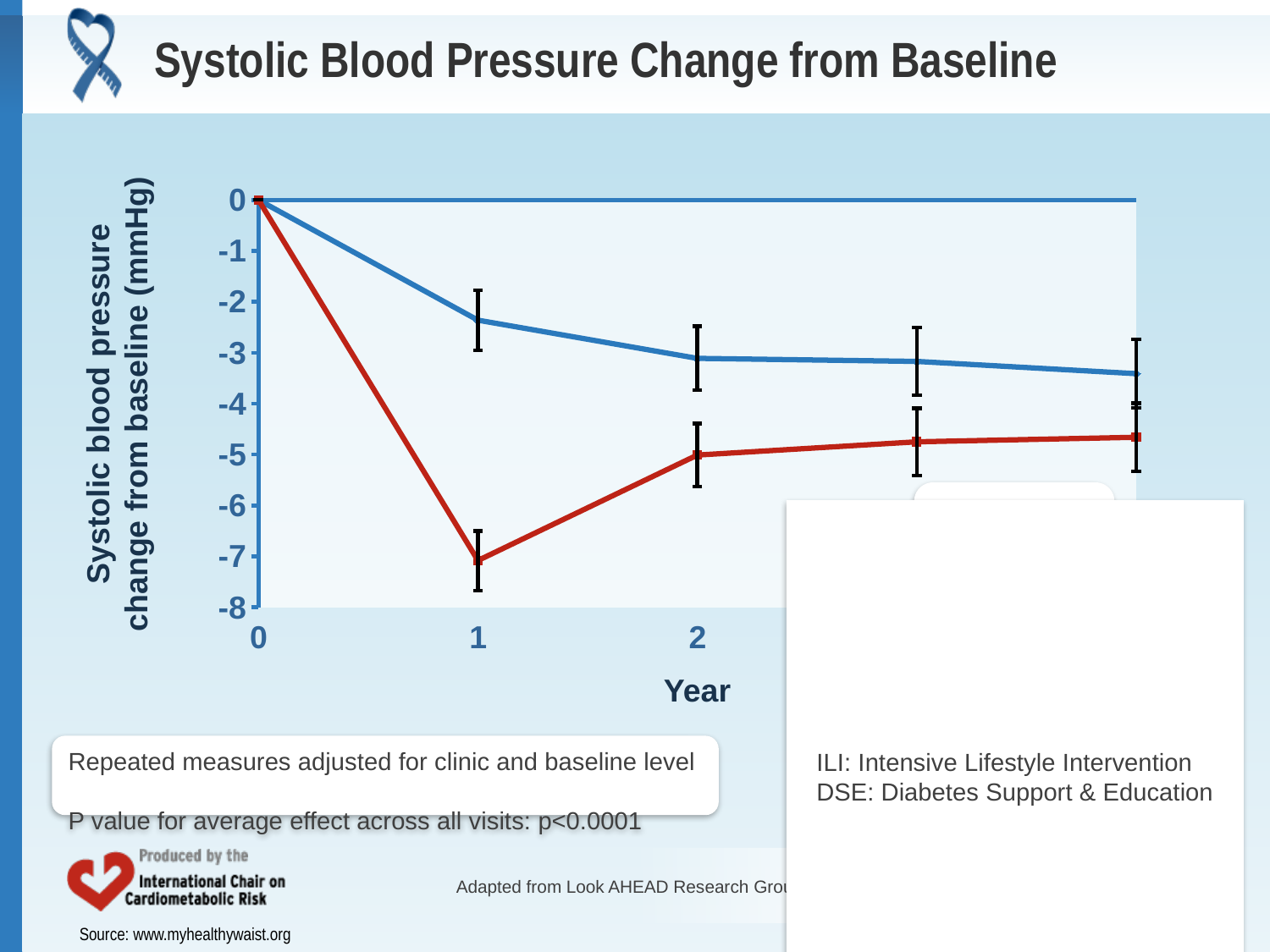
At which year does the red line reach its lowest value? 1 What is the label of the x axis? Year Is the value of the red line at year 1 greater or less than -6? less What is the title of the chart? Systolic Blood Pressure Change from Baseline What is the value of the red line at year 0? 0 Is the value of the blue line at year 2 greater or less than -4? greater At year 1, which line has the higher value, the red line or the blue line? the blue line Is the value of the blue line at year 1 greater or less than -3? greater What kind of chart is shown on the slide? line chart What is the value of the blue line at year 0? 0 Does the blue line rise or fall from year 0 to year 2? fall